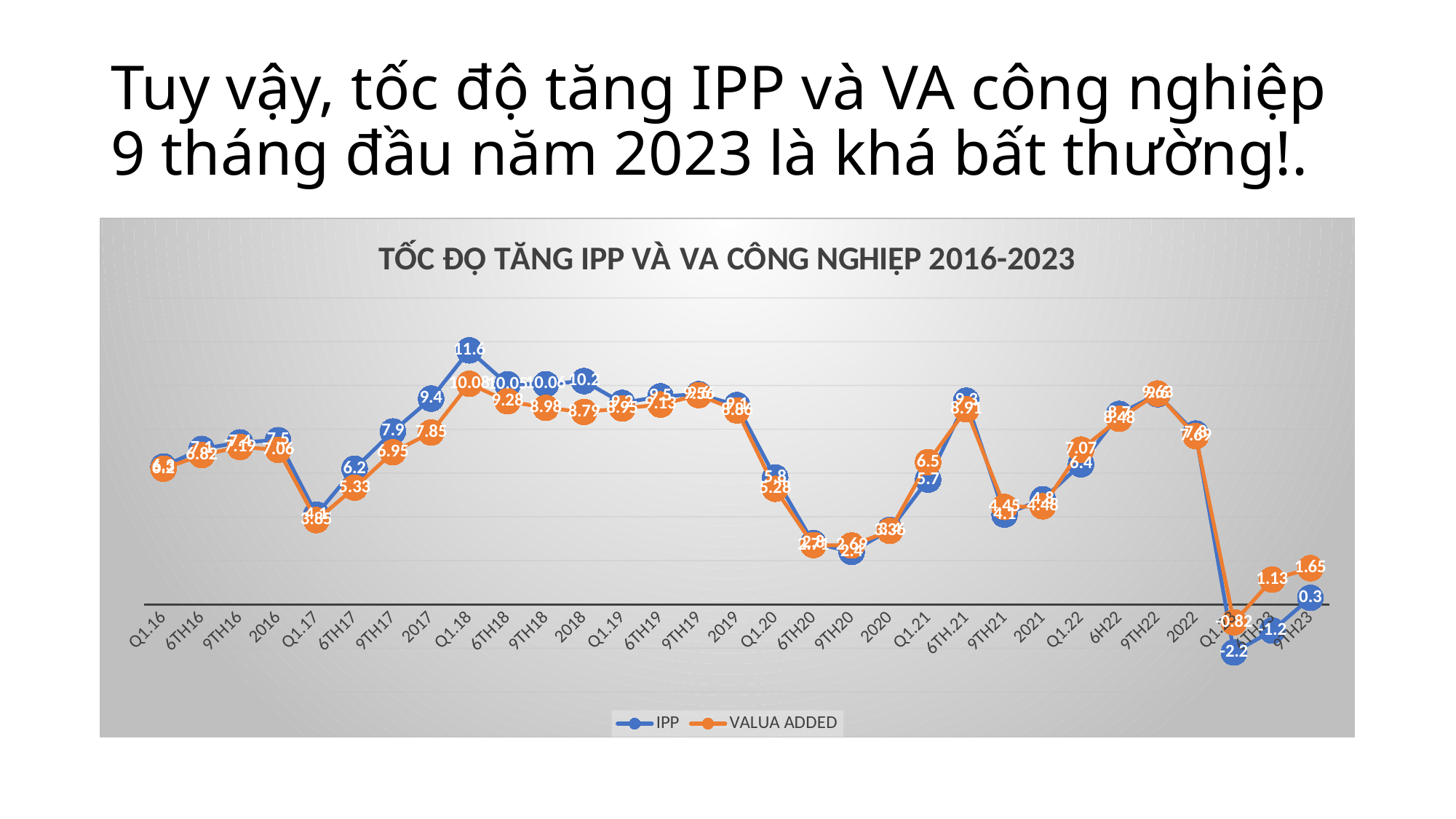
What is the title of the chart? TỐC ĐỘ TĂNG IPP VÀ VA CÔNG NGHIỆP 2016-2023 What is the VALUA ADDED value for 9TH23? 1.65 How many series does the legend list? 2 What is the IPP value for Q1.23? -2.2 What is the difference between the IPP and VALUA ADDED values for Q1.18? 1.52 In which period does the IPP series reach its highest value? Q1.18 Which is larger for 6TH17, the IPP value or the VALUA ADDED value? IPP What is the VALUA ADDED value for Q1.18? 10.08 What type of chart is shown on the slide? line chart In which period does the IPP series reach its lowest value? Q1.23 What is the IPP value for Q1.18? 11.6 What is the difference between the IPP value for 2017 and the IPP value for 6TH17? 3.2